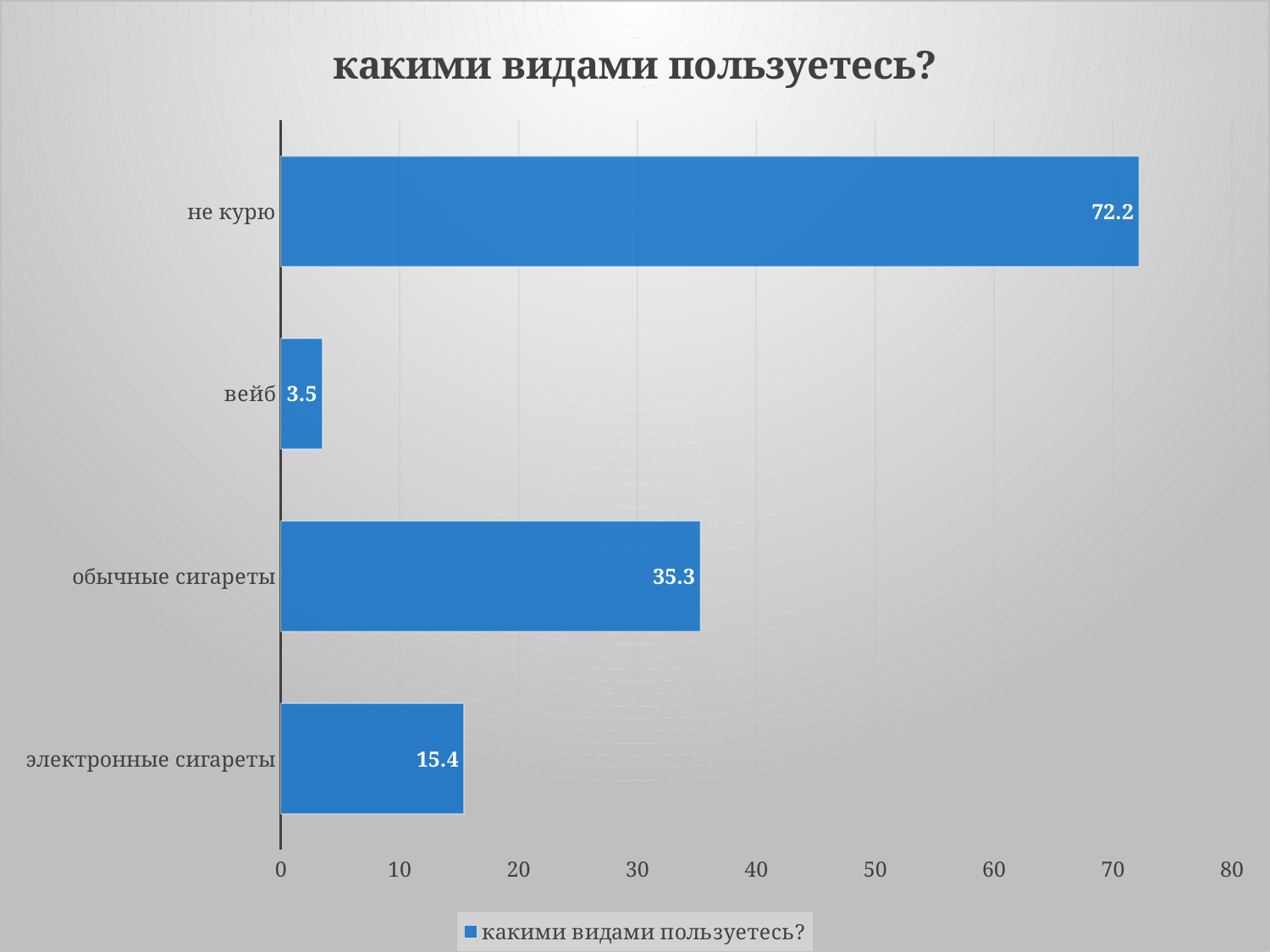
Which is larger, the value for "обычные сигареты" or the value for "электронные сигареты"? обычные сигареты Which category has the lowest value? вейб What is the value for "не курю"? 72.2 What is the value for "обычные сигареты"? 35.3 What is the value for "вейб"? 3.5 What is the difference between the values for "обычные сигареты" and "электронные сигареты"? 19.9 Which category has the highest value? не курю What is the title of the chart? какими видами пользуетесь? What is the value for "электронные сигареты"? 15.4 How many categories are shown in the chart? 4 Is the value for "не курю" greater or less than 70? greater What kind of chart is shown on the slide? bar chart